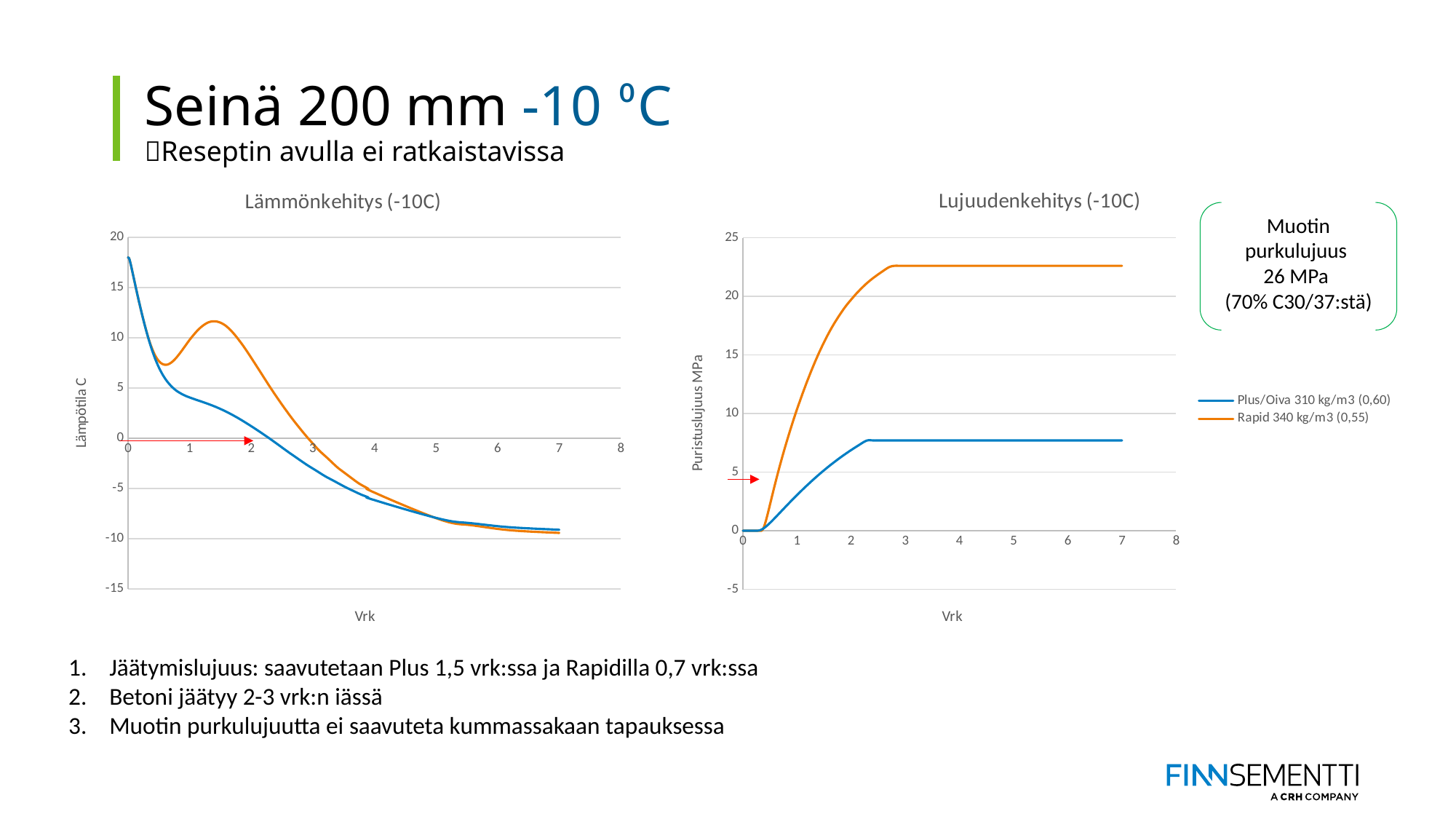
In the Lämmönkehitys (-10C) chart, is the peak of the Rapid 340 kg/m3 (0,55) line around day 1.5 greater or less than 10? greater How many series does the legend list for the charts? 2 In the Lämmönkehitys (-10C) chart, which series has the higher temperature at day 1? Rapid 340 kg/m3 (0,55) What is the x-axis label of the Lämmönkehitys (-10C) chart? Vrk What kind of chart is the Lämmönkehitys (-10C) chart? line chart In the Lujuudenkehitys (-10C) chart, is the final plateau value of the Rapid 340 kg/m3 (0,55) line greater or less than 20? greater In the Lujuudenkehitys (-10C) chart, which series reaches the higher strength at day 7? Rapid 340 kg/m3 (0,55) In the Lämmönkehitys (-10C) chart, does the Plus/Oiva 310 kg/m3 (0,60) line generally rise or fall from day 0 to day 7? fall What is the y-axis label of the Lujuudenkehitys (-10C) chart? Puristuslujuus MPa In the Lujuudenkehitys (-10C) chart, is the final plateau value of the Plus/Oiva 310 kg/m3 (0,60) line greater or less than 10? less What kind of chart is the Lujuudenkehitys (-10C) chart? line chart